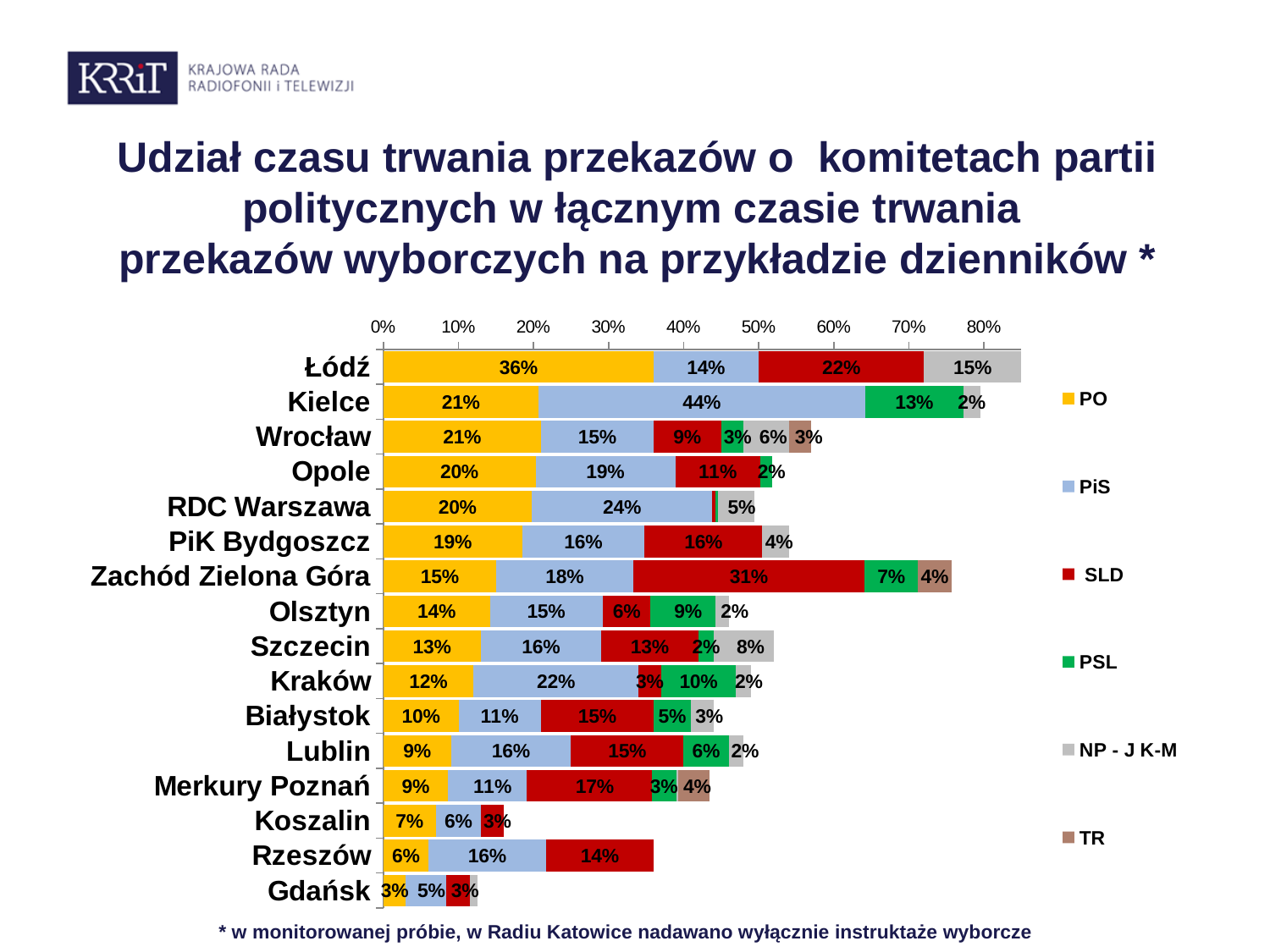
Which station has the highest PO share? Łódź How many series does the legend list? 6 Which is larger for Rzeszów: the PiS share or the SLD share? PiS What is the SLD share for Zachód Zielona Góra? 31% How many stations are listed on the chart? 16 Which station has the lowest PO share? Gdańsk What is the total of the stacked bar for Rzeszów? 36% What is the PiS share for Kielce? 44% Which series is shown in red in the legend? SLD What kind of chart is shown on the slide? Stacked bar chart What is the PO share for Łódź? 36% What is the difference between the PiS share and the PO share for Kielce? 23%